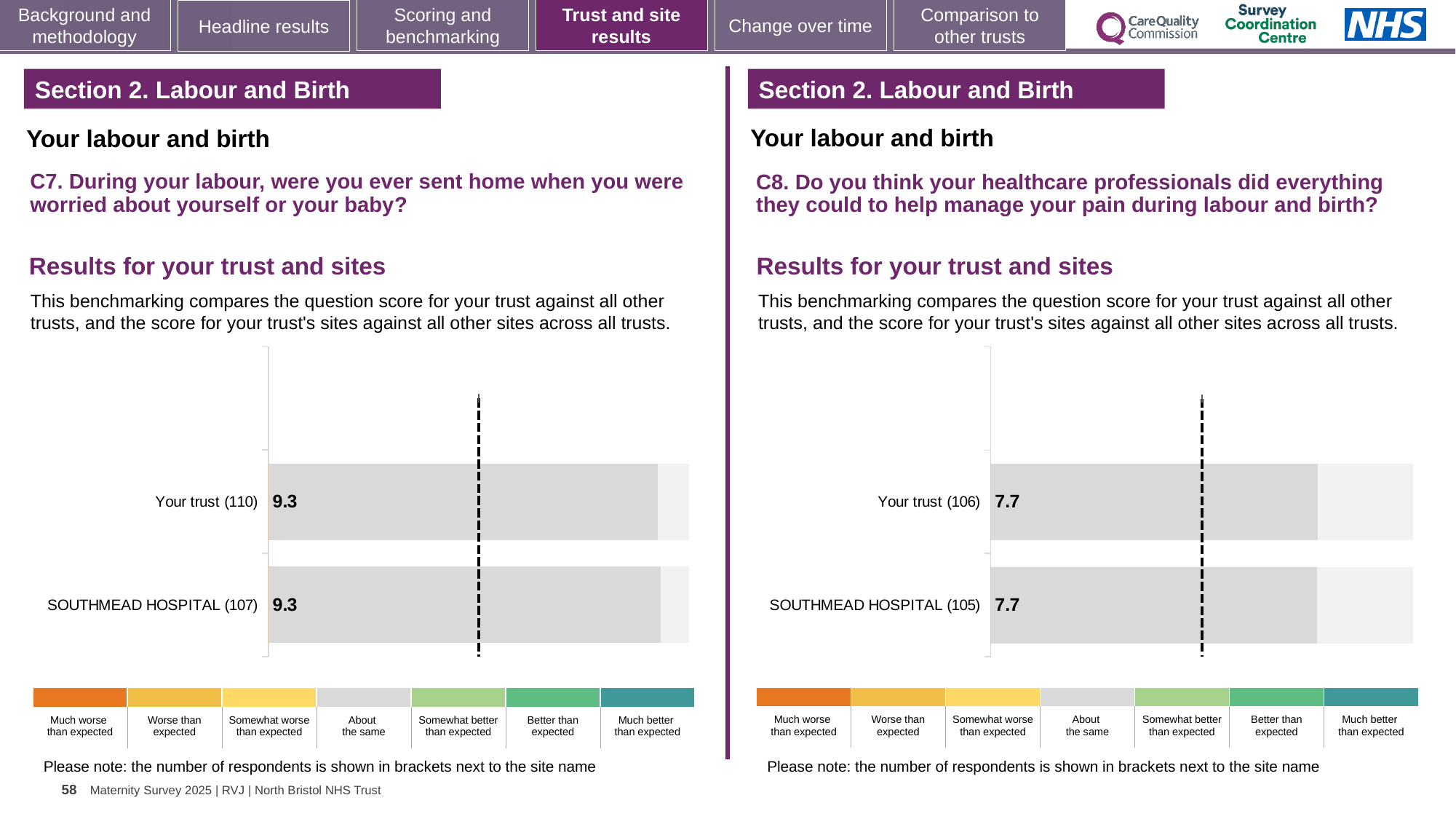
In the C8 chart on the right, how many bars are plotted? 2 In the C7 chart on the left, how many respondents are shown in brackets for Your trust? 110 In the C8 chart on the right, what is the score for SOUTHMEAD HOSPITAL? 7.7 What kind of chart is the C8 chart on the right? bar chart In the C7 chart on the left, what is the score for SOUTHMEAD HOSPITAL? 9.3 In the C7 chart on the left, how many bars are plotted? 2 In the C8 chart on the right, what is the score for Your trust? 7.7 Is the score for Your trust in the C7 chart on the left larger or smaller than the score for Your trust in the C8 chart on the right? larger In the C7 chart on the left, what is the difference between the score for Your trust and the score for SOUTHMEAD HOSPITAL? 0 In the C8 chart on the right, how many respondents are shown in brackets for SOUTHMEAD HOSPITAL? 105 In the C7 chart on the left, which category label is shown in the colour key at the far right end? Much better than expected In the C7 chart on the left, what is the score for Your trust? 9.3